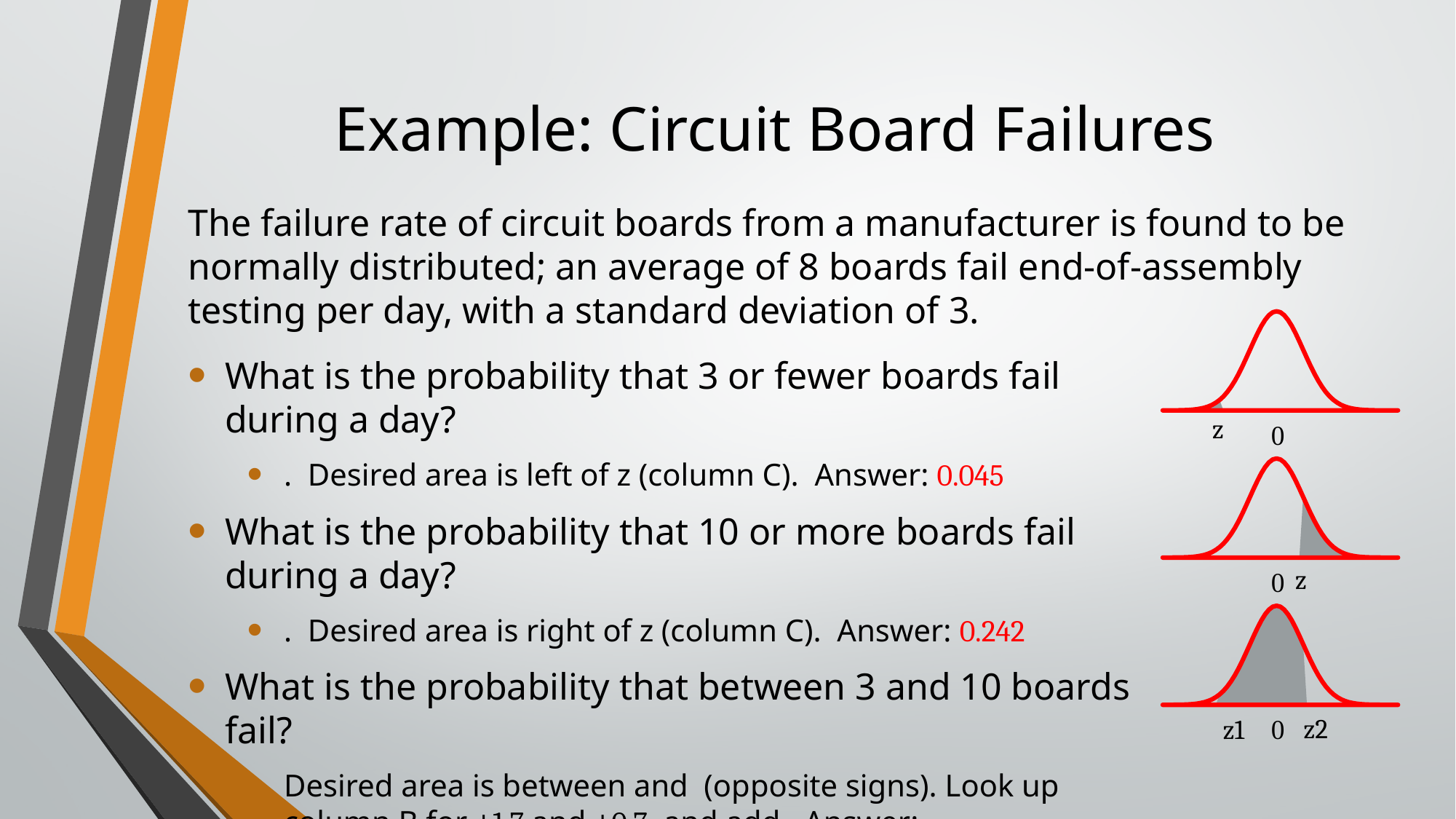
In the middle normal curve diagram, is the shaded area to the left or right of z? right How many normal distribution curve diagrams are shown on the right side of the slide? 3 In the bottom normal curve diagram, what labels appear along the horizontal axis? z1, 0, z2 In the bottom normal curve diagram, is the shaded area between z1 and z2 or outside them? between z1 and z2 What colour are the curves in the normal distribution diagrams? red